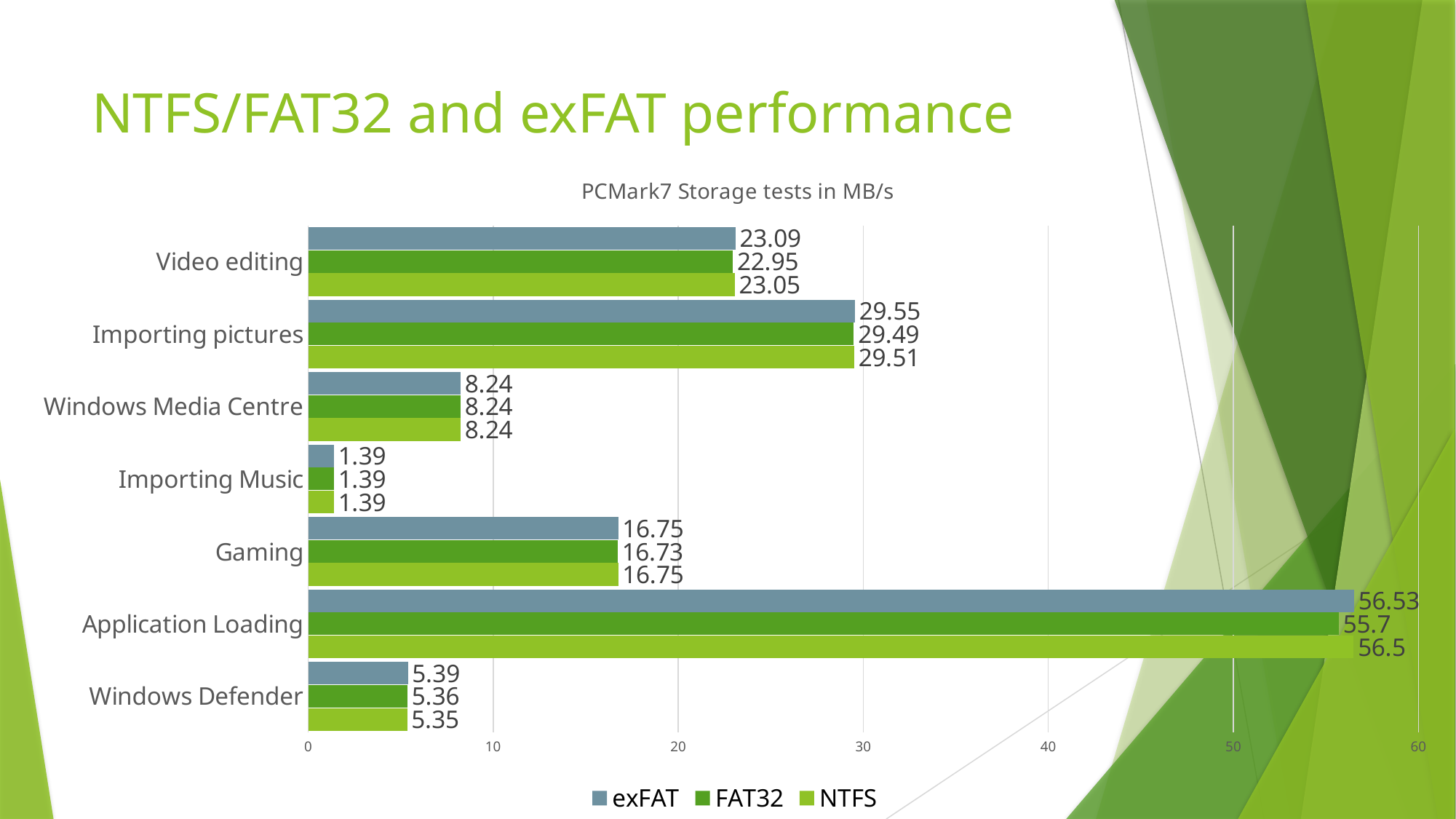
What is the exFAT value for Video editing? 23.09 Which category has the highest exFAT value? Application Loading What is the title of the chart? PCMark7 Storage tests in MB/s What is the difference between the exFAT and FAT32 values for Application Loading? 0.83 What is the NTFS value for Windows Defender? 5.35 Is the NTFS value for Importing pictures greater or less than 20? greater How many categories are shown on the chart? 7 Which category has the lowest NTFS value? Importing Music Which is larger for Video editing, the exFAT value or the FAT32 value? exFAT What kind of chart is shown on the slide? bar chart What is the FAT32 value for Application Loading? 55.7 How many series does the legend list? 3